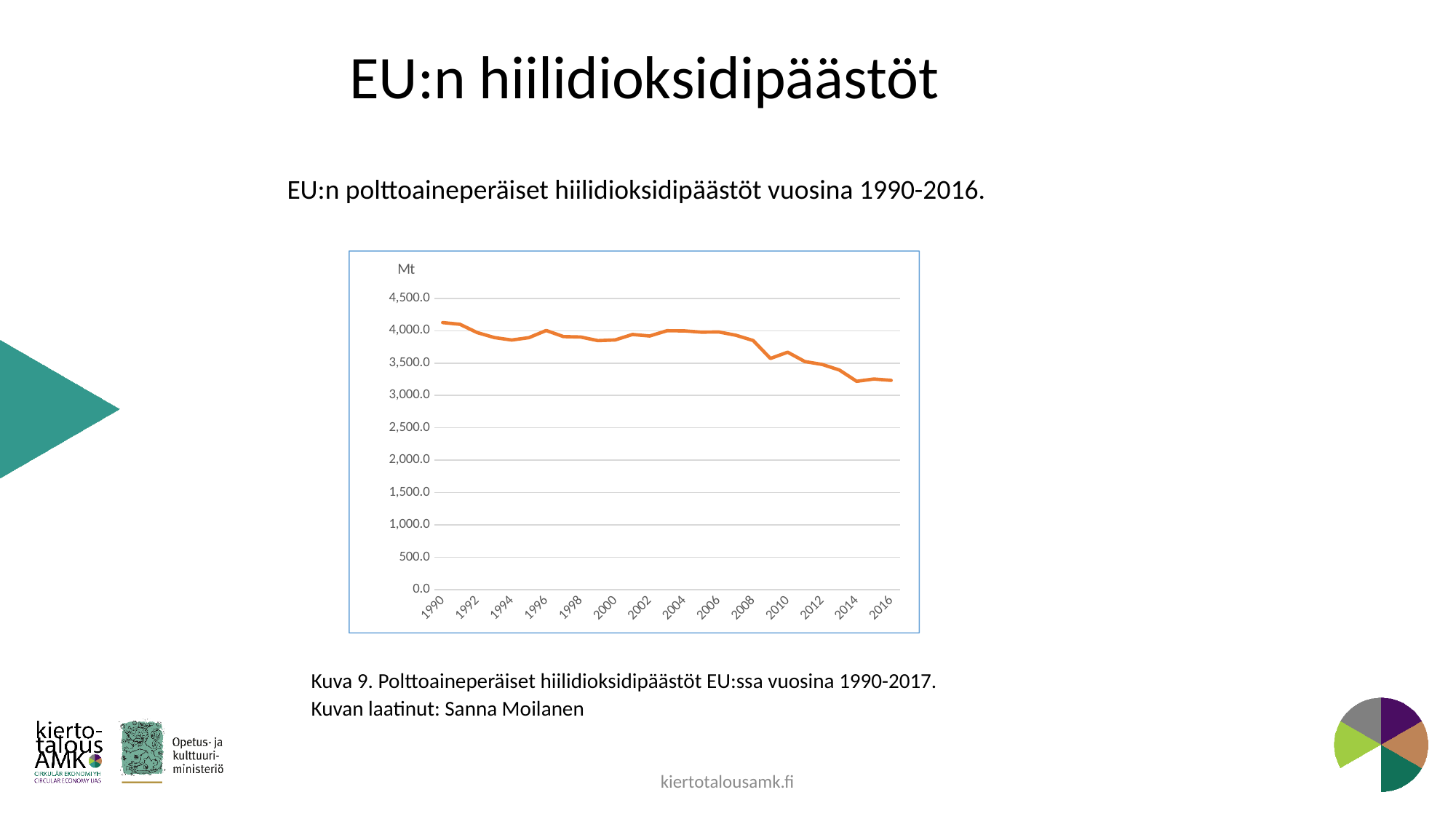
Which year has the highest emissions value in the chart? 1990 How many year labels are shown on the x axis? 14 What unit is shown at the top of the y axis? Mt Is the value for 2010 greater or less than 4,000.0 Mt? less Which year has the larger emissions value, 1990 or 2016? 1990 Which year has the larger emissions value, 2008 or 2010? 2008 Is the value for 2016 greater or less than 3,500.0 Mt? less Is the value for 1990 greater or less than 4,000.0 Mt? greater What kind of chart is shown on the slide? line chart Do the EU carbon dioxide emissions generally rise or fall from 1990 to 2016? fall What is the highest tick value shown on the y axis? 4,500.0